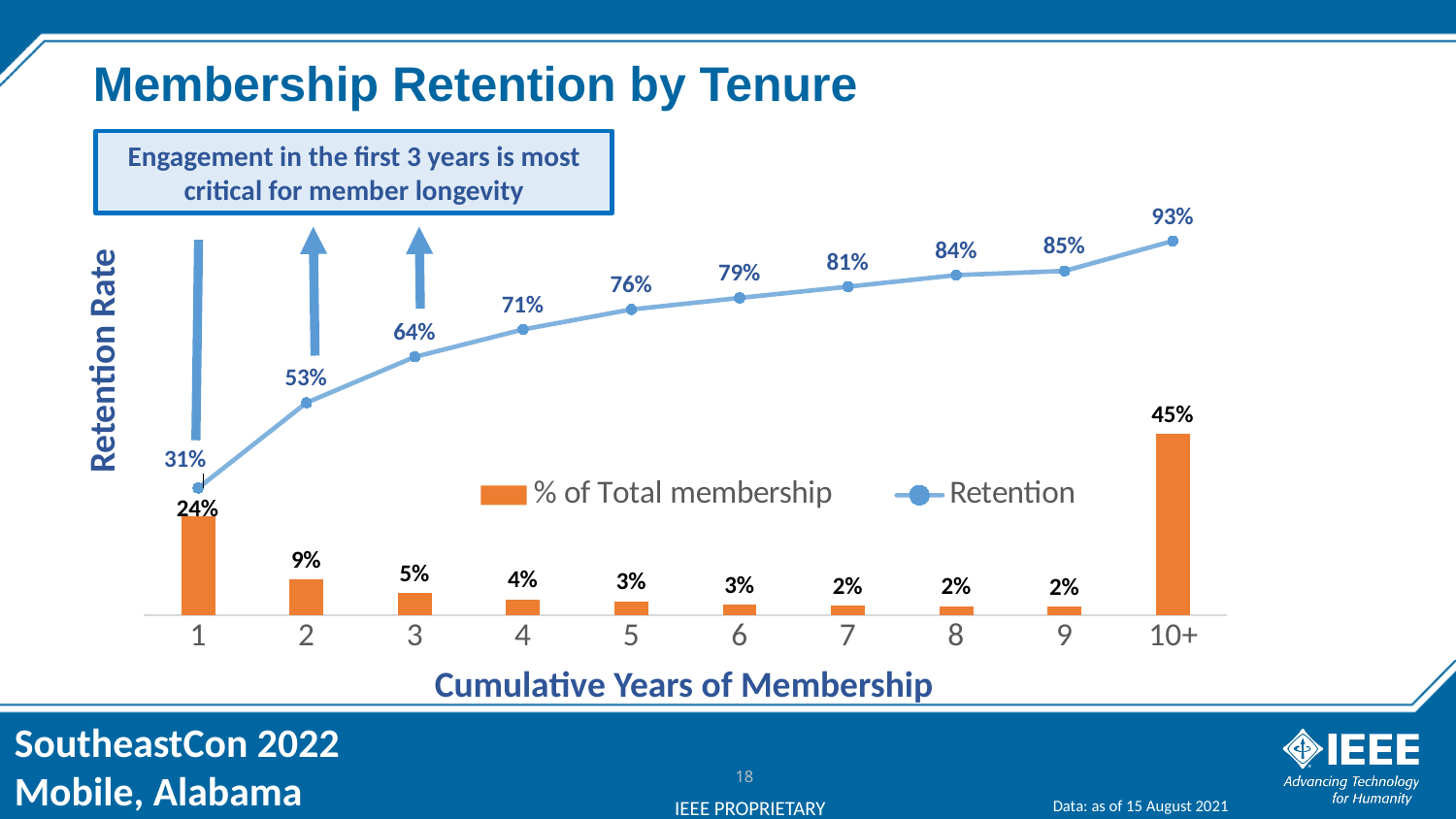
What is the retention rate at 5 cumulative years of membership? 76% What is the retention rate for members with 1 cumulative year of membership? 31% What percentage of total membership has 10+ cumulative years of membership? 45% What kinds of chart are combined on this slide? A bar chart and a line chart Which cumulative years of membership category has the lowest % of total membership? 7, 8 and 9 (all 2%) What is the difference in retention rate between 2 years and 1 year of membership? 22 percentage points What is the title of the chart? Membership Retention by Tenure How many cumulative years of membership categories are shown on the x axis? 10 Which is larger: the % of total membership at 1 year or at 10+ years? 10+ years How many series does the legend list? 2 Which cumulative years of membership category has the highest retention rate? 10+ Does the retention rate rise or fall as cumulative years of membership increase? Rise